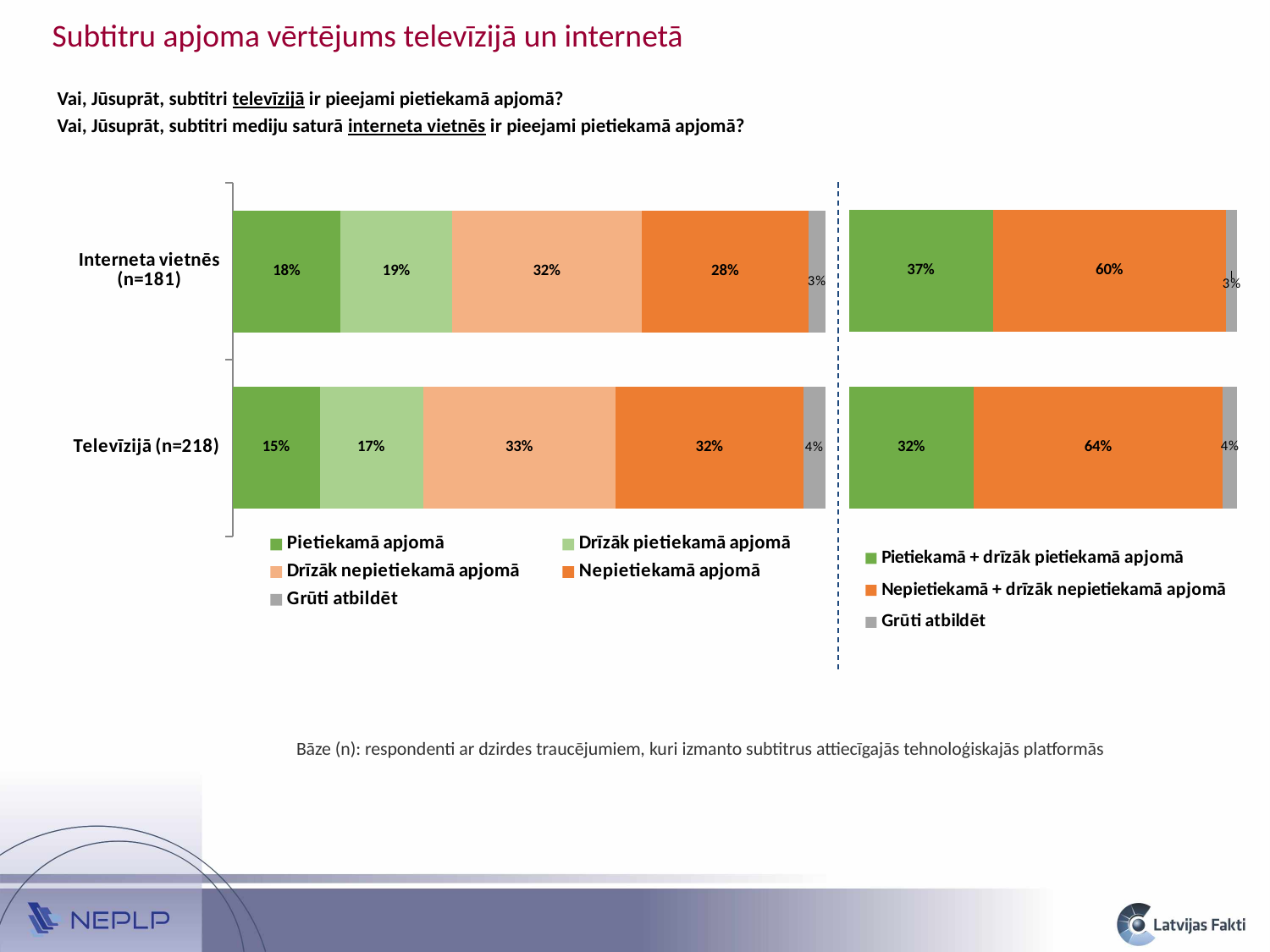
In the right chart, what is the value for "Nepietiekamā + drīzāk nepietiekamā apjomā" for Televīzijā (n=218)? 64% In the left chart, what is the value for "Nepietiekamā apjomā" for Televīzijā (n=218)? 32% In the left chart, what is the value for "Pietiekamā apjomā" for Interneta vietnēs (n=181)? 18% What kind of chart is the left chart? Stacked bar chart In the left chart, which segment is the smallest for Interneta vietnēs (n=181)? Grūti atbildēt How many series does the legend of the right chart list? 3 How many series does the legend of the left chart list? 5 In the right chart, what is the difference between the "Nepietiekamā + drīzāk nepietiekamā apjomā" values for Televīzijā (n=218) and Interneta vietnēs (n=181)? 4% In the right chart, what is the value for "Pietiekamā + drīzāk pietiekamā apjomā" for Interneta vietnēs (n=181)? 37% In the left chart, which segment is the largest for Televīzijā (n=218)? Drīzāk nepietiekamā apjomā In the left chart, which is larger: "Drīzāk pietiekamā apjomā" for Interneta vietnēs (n=181) or for Televīzijā (n=218)? Interneta vietnēs (n=181) In the left chart, what is the value for "Drīzāk nepietiekamā apjomā" for Interneta vietnēs (n=181)? 32%